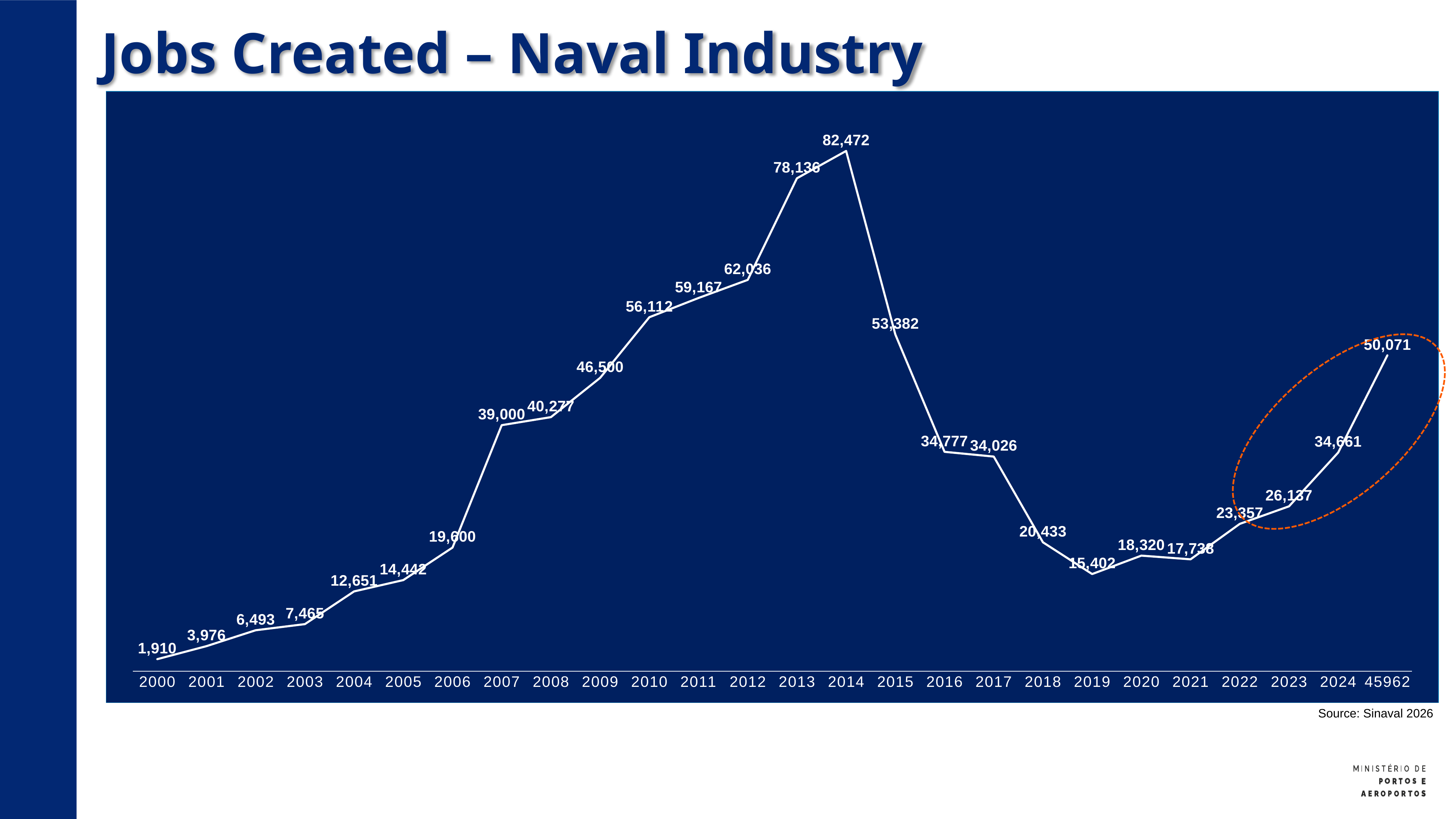
How many data points are plotted on the chart? 26 What kind of chart is shown on the slide? line chart How many jobs were created in 2014? 82,472 Do the values rise or fall from 2014 to 2019? fall What is the value for 2024? 34,661 What is the difference between the values for 2010 and 2009? 9,612 What is the value for 2007? 39,000 Which is larger, the value for 2016 or the value for 2017? 2016 What is the difference between the values for 2014 and 2015? 29,090 Which year has the lowest number of jobs created? 2000 Which year has the highest number of jobs created? 2014 What is the value for 2000? 1,910